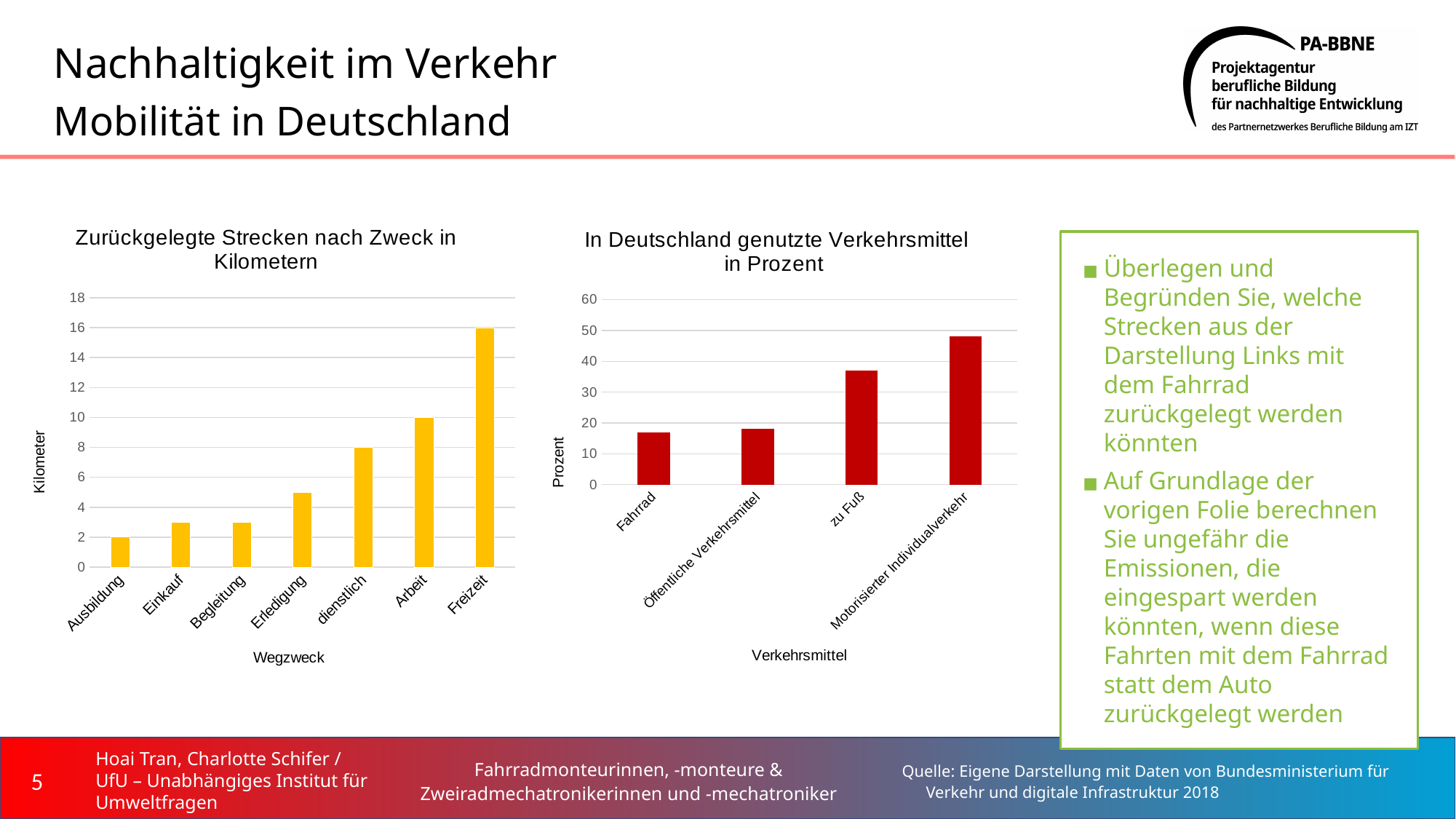
In the right chart 'In Deutschland genutzte Verkehrsmittel in Prozent', is the value for zu Fuß greater or less than 30? greater In the left chart 'Zurückgelegte Strecken nach Zweck in Kilometern', what is the value for Arbeit? 10 In the left chart 'Zurückgelegte Strecken nach Zweck in Kilometern', how many categories are shown on the x axis? 7 In the left chart 'Zurückgelegte Strecken nach Zweck in Kilometern', which category has the highest value? Freizeit In the left chart 'Zurückgelegte Strecken nach Zweck in Kilometern', what is the difference between the values for Freizeit and Arbeit? 6 In the right chart 'In Deutschland genutzte Verkehrsmittel in Prozent', how many categories are shown on the x axis? 4 In the left chart 'Zurückgelegte Strecken nach Zweck in Kilometern', which is larger: dienstlich or Erledigung? dienstlich What kind of chart is the left chart, 'Zurückgelegte Strecken nach Zweck in Kilometern'? bar chart In the left chart 'Zurückgelegte Strecken nach Zweck in Kilometern', which category has the lowest value? Ausbildung In the left chart 'Zurückgelegte Strecken nach Zweck in Kilometern', what is the value for Freizeit? 16 In the right chart 'In Deutschland genutzte Verkehrsmittel in Prozent', which category has the highest value? Motorisierter Individualverkehr In the left chart 'Zurückgelegte Strecken nach Zweck in Kilometern', do the values rise or fall from left to right along the x axis? rise